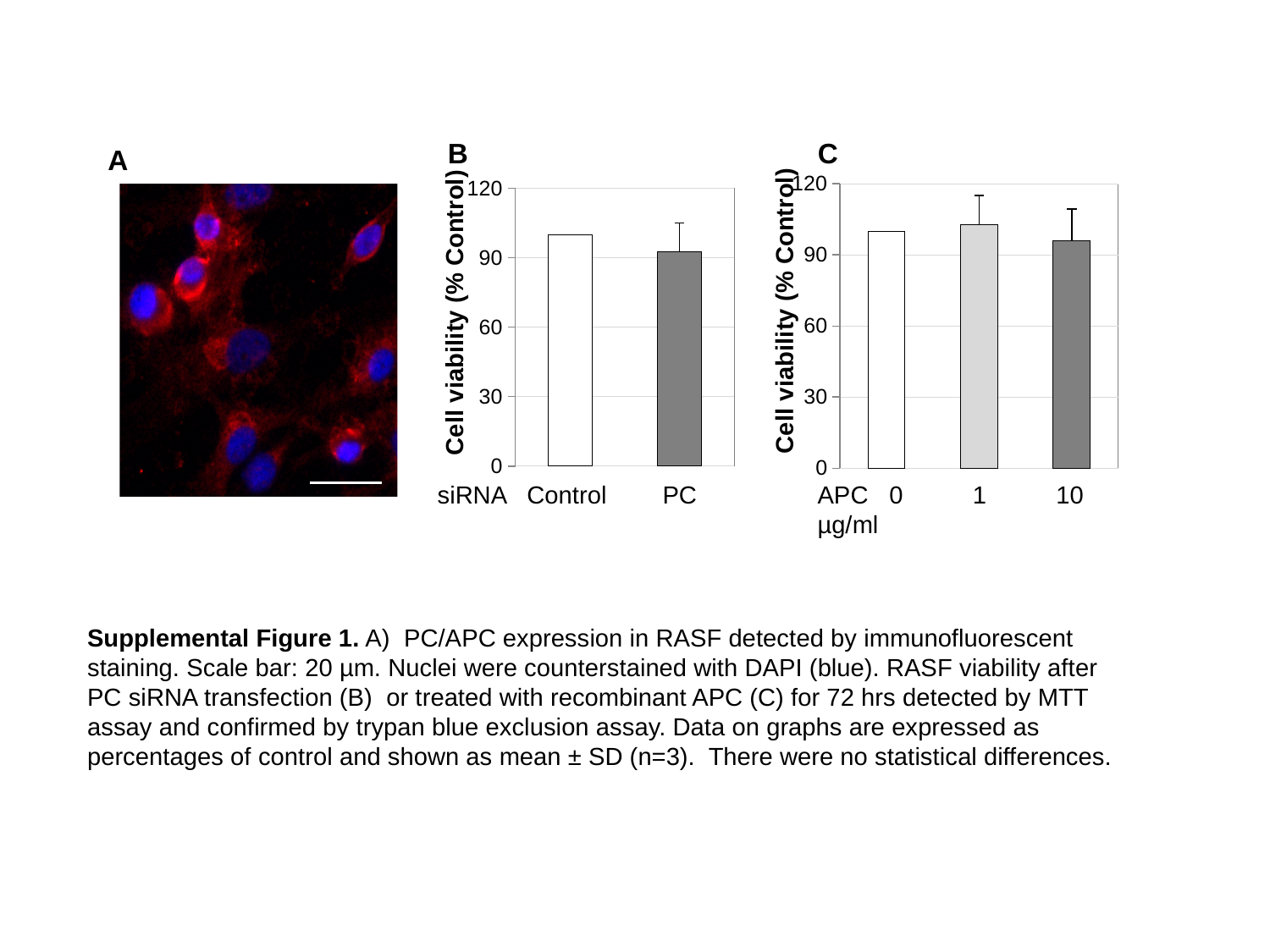
How many bars are shown in chart C? 3 What kind of chart is chart B? bar chart What is the y-axis label of chart B? Cell viability (% Control) How many bars are shown in chart B? 2 In chart C, is the value for 1 µg/ml APC greater or less than 120? less In chart B, is the value for Control greater or less than 120? less In chart B, which bar is taller, Control or PC? Control What kind of chart is chart C? bar chart What are the x-axis categories in chart C? 0, 1, 10 In chart B, which category has the highest cell viability? Control In chart B, is the value for PC greater or less than 60? greater